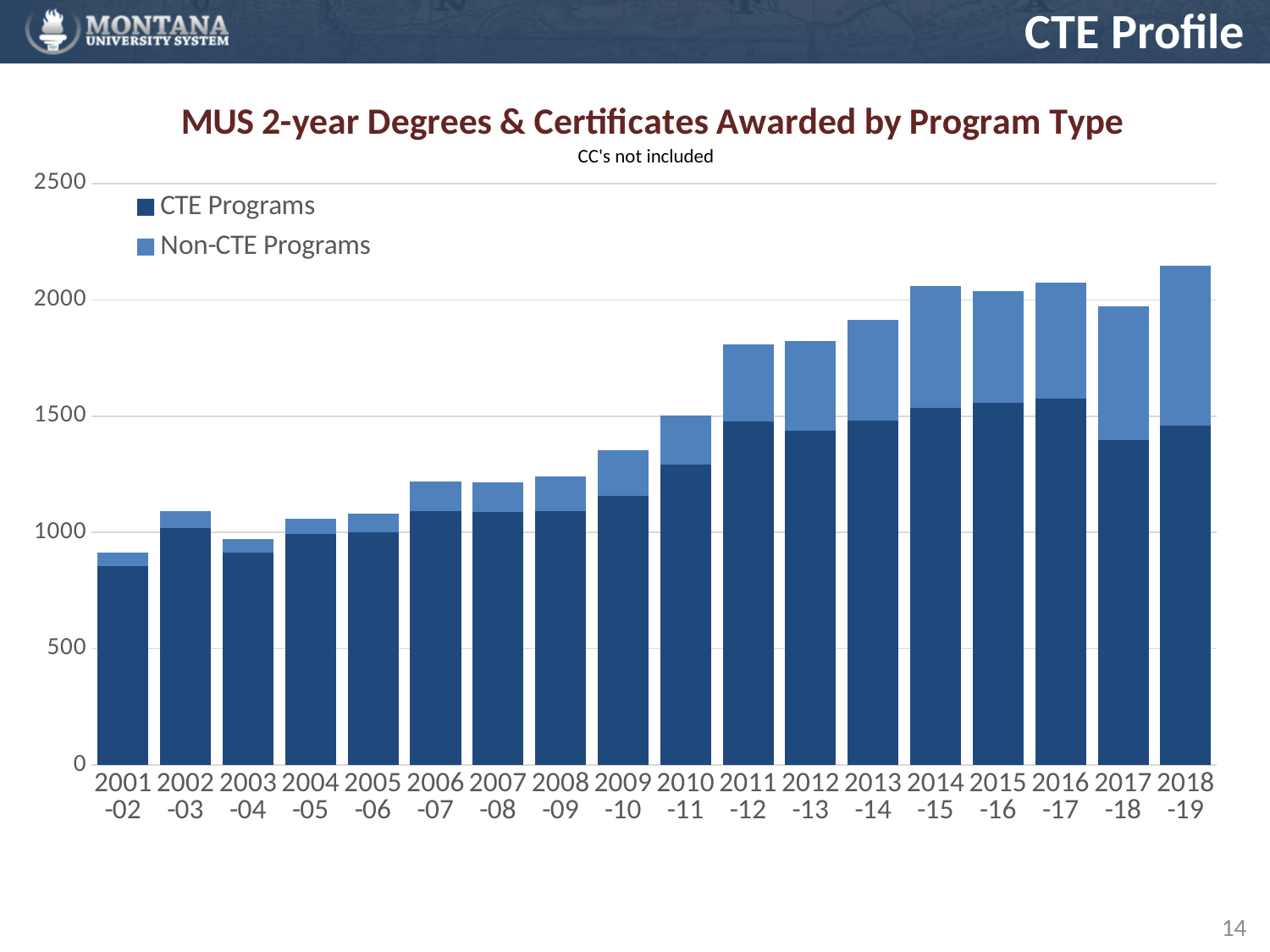
Is the total bar for 2018-19 greater or less than 2000? greater Is the value for CTE Programs in 2001-02 greater or less than 1000? less What does the subtitle under the chart title say is not included? CC's Is the total bar for 2009-10 greater or less than 1500? less Which academic year has the highest total of degrees and certificates awarded? 2018-19 Do the total degrees and certificates awarded generally rise or fall from 2001-02 to 2018-19? Rise How many academic years are shown on the x axis? 18 What kind of chart is shown on the slide? Stacked bar chart How many series does the legend list? 2 Which academic year has the lowest total of degrees and certificates awarded? 2001-02 Which is larger, the CTE Programs value for 2016-17 or for 2017-18? 2016-17